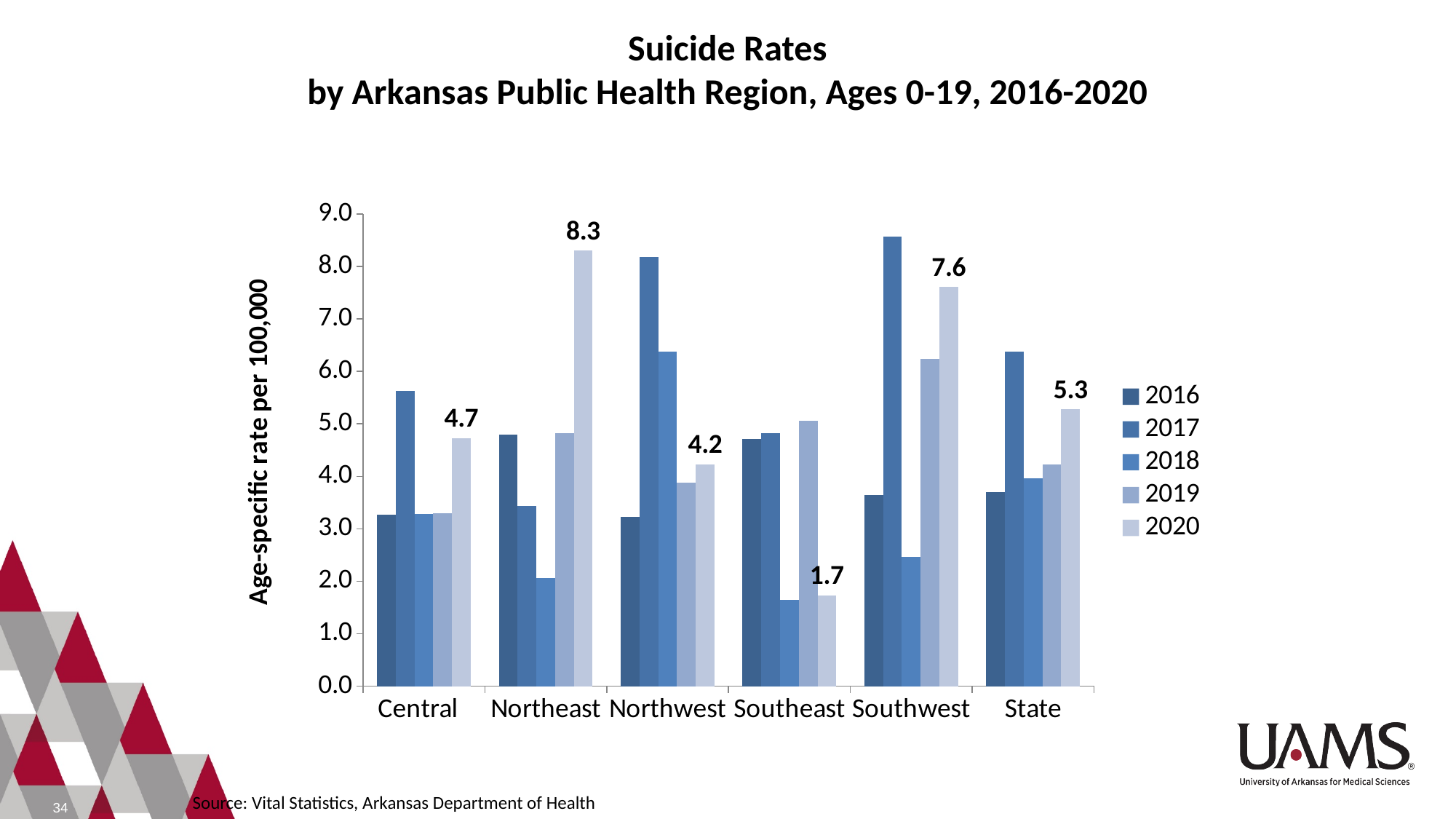
Is the 2018 value for Northeast greater or less than 3.0? less What is the 2020 value for the State? 5.3 How many series does the legend list? 5 Which region has the lowest 2020 value? Southeast What is the 2020 value for the Southeast region? 1.7 What is the 2020 suicide rate for the Northeast region? 8.3 Which region has the highest 2020 value? Northeast How many regions (categories) are shown on the x axis? 6 Which is larger, the 2020 value for Northeast or for Southwest? Northeast What kind of chart is shown on the slide? Bar chart Is the 2017 value for Southwest greater or less than 8.0? greater What is the difference between the 2020 values for Northeast and Southeast? 6.6